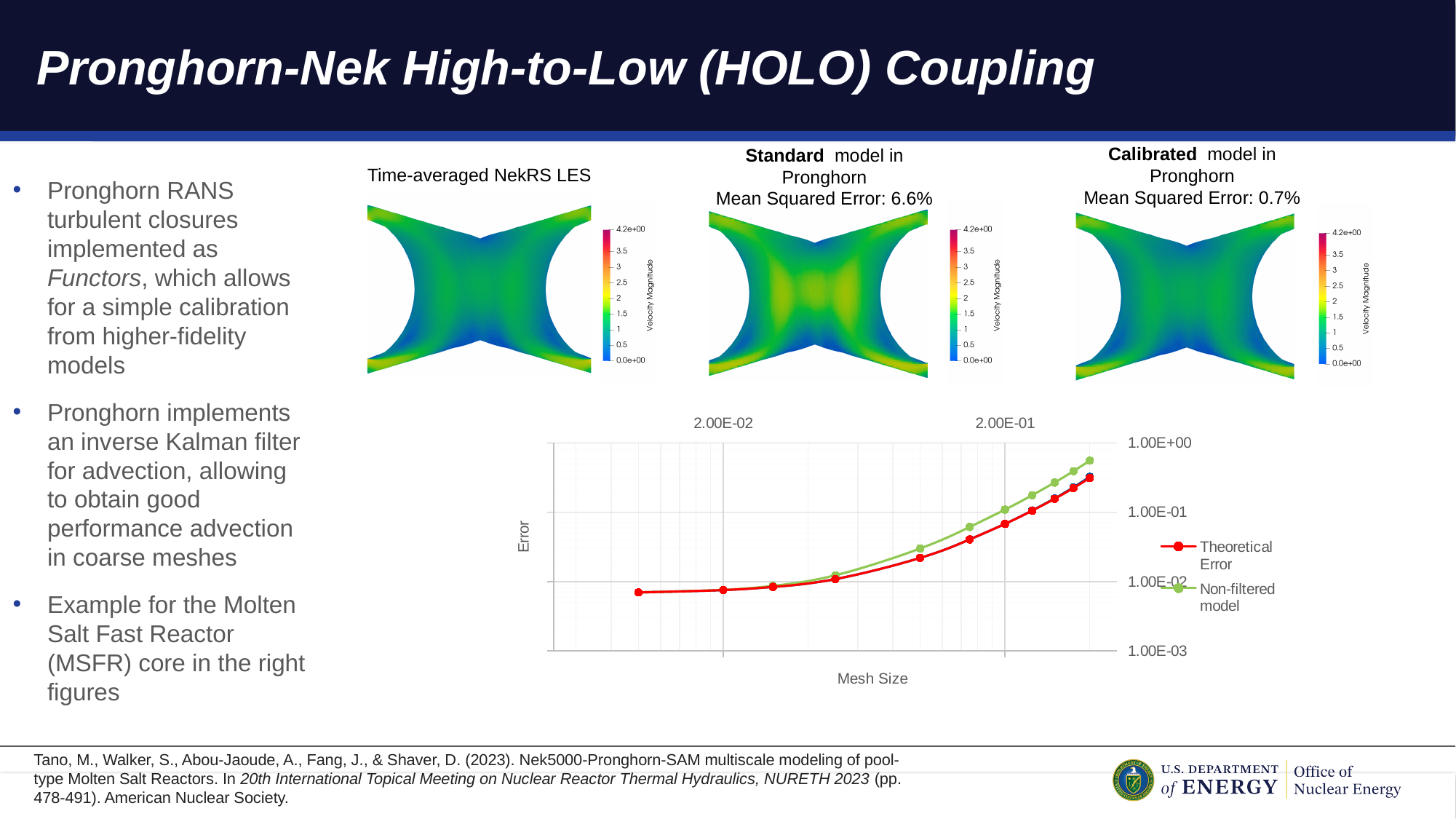
What kind of chart is the Error vs Mesh Size chart at the bottom of the slide? line chart What are the axis titles of the line chart at the bottom of the slide? Mesh Size (x axis) and Error (y axis) What Mean Squared Error is reported for the Standard model in Pronghorn contour plot? 6.6% In the Error vs Mesh Size chart, is the Theoretical Error at the largest mesh size greater or less than 1.00E-01? greater By how much does the Mean Squared Error of the Standard model in Pronghorn exceed that of the Calibrated model in Pronghorn? 5.9% In the Error vs Mesh Size chart, does the error rise or fall as mesh size increases along the x axis? rise In the Error vs Mesh Size chart, is the Non-filtered model error at the largest mesh size greater or less than 1.00E-01? greater What Mean Squared Error is reported for the Calibrated model in Pronghorn contour plot? 0.7% In the Error vs Mesh Size chart, at the largest mesh size, which series has the higher error: Theoretical Error or Non-filtered model? Non-filtered model In the Error vs Mesh Size chart, is the Theoretical Error at the smallest mesh size greater or less than 1.00E-01? less How many series does the legend of the Error vs Mesh Size chart list? 2 What are the two series named in the legend of the Error vs Mesh Size chart? Theoretical Error and Non-filtered model